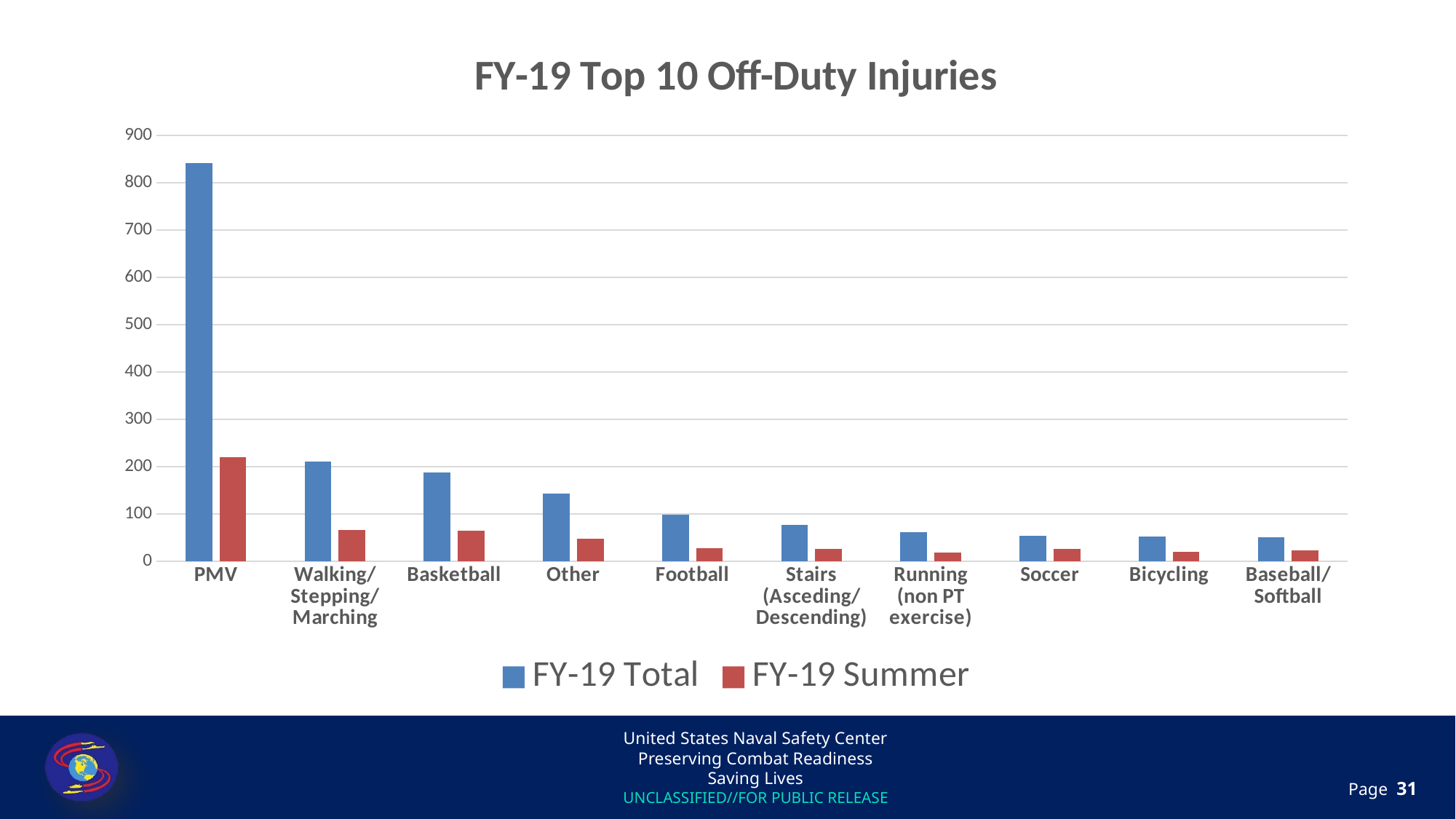
How many series does the legend list? 2 Which is larger, the FY-19 Total value for Football or the FY-19 Total value for Stairs (Asceding/Descending)? Football What type of chart is shown on the slide? Bar chart Is the FY-19 Total value for Other greater or less than 100? greater Do the FY-19 Total values generally rise or fall moving from left to right along the x axis? Fall How many injury categories are shown on the x axis? 10 What is the title of the chart? FY-19 Top 10 Off-Duty Injuries Which category has the highest FY-19 Total value? PMV Is the FY-19 Total value for PMV greater or less than 800? greater Which category has the highest FY-19 Summer value? PMV Is the FY-19 Total value for Basketball greater or less than 200? less